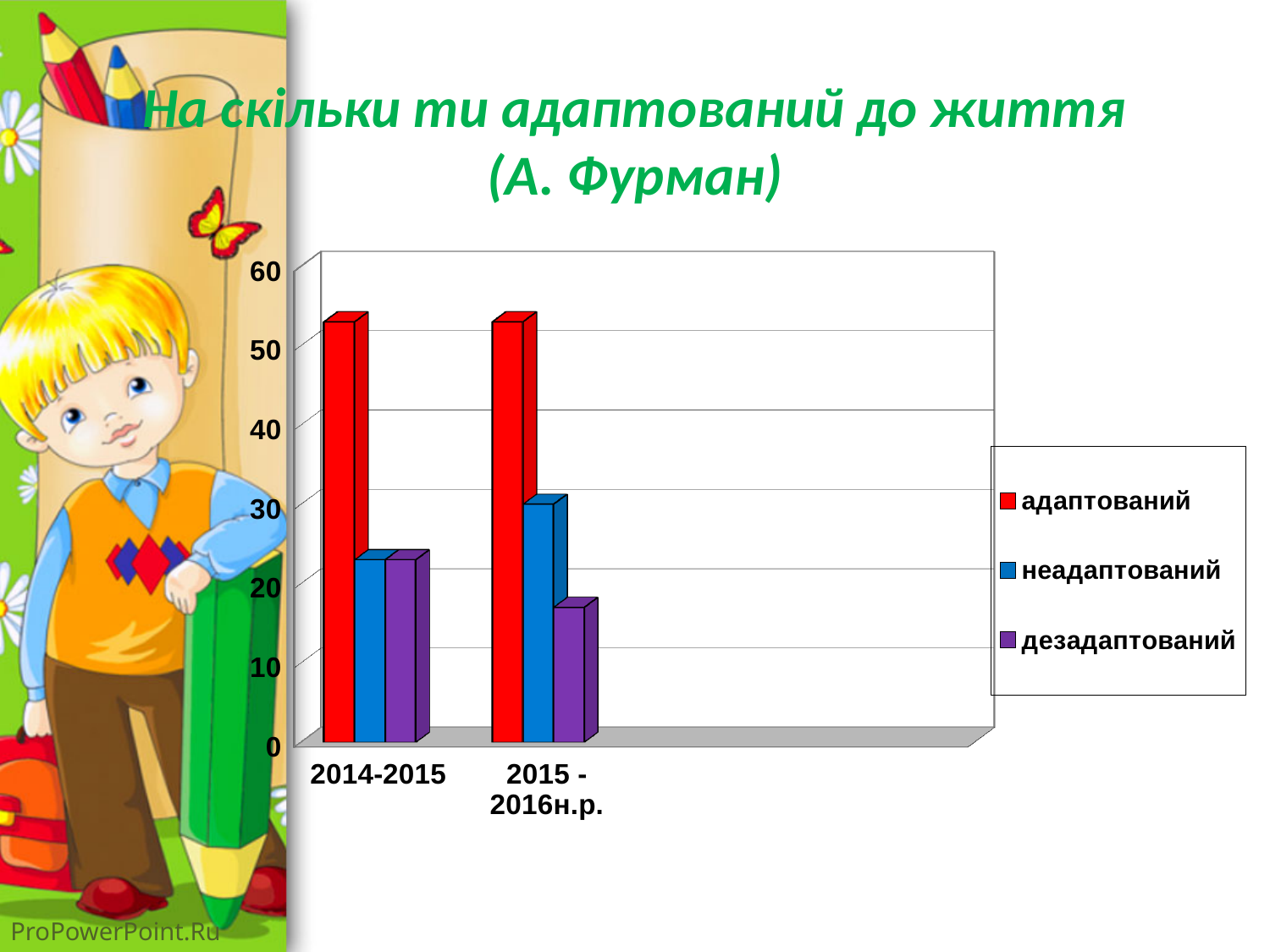
Is the value for дезадаптований in 2015 - 2016н.р. greater or less than 20? less Which series has the lowest value in 2015 - 2016н.р.? дезадаптований Which is larger in 2015 - 2016н.р., неадаптований or дезадаптований? неадаптований For неадаптований, which year has the larger value, 2014-2015 or 2015 - 2016н.р.? 2015 - 2016н.р. Is the value for неадаптований in 2015 - 2016н.р. greater or less than 40? less How many series does the legend list? 3 How many categories are shown on the x axis? 2 Is the value for адаптований in 2014-2015 greater or less than 40? greater What kind of chart is shown on the slide? bar chart What colour represents the series адаптований in the legend? red Does the value for дезадаптований rise or fall from 2014-2015 to 2015 - 2016н.р.? fall Which series has the highest value in 2014-2015? адаптований